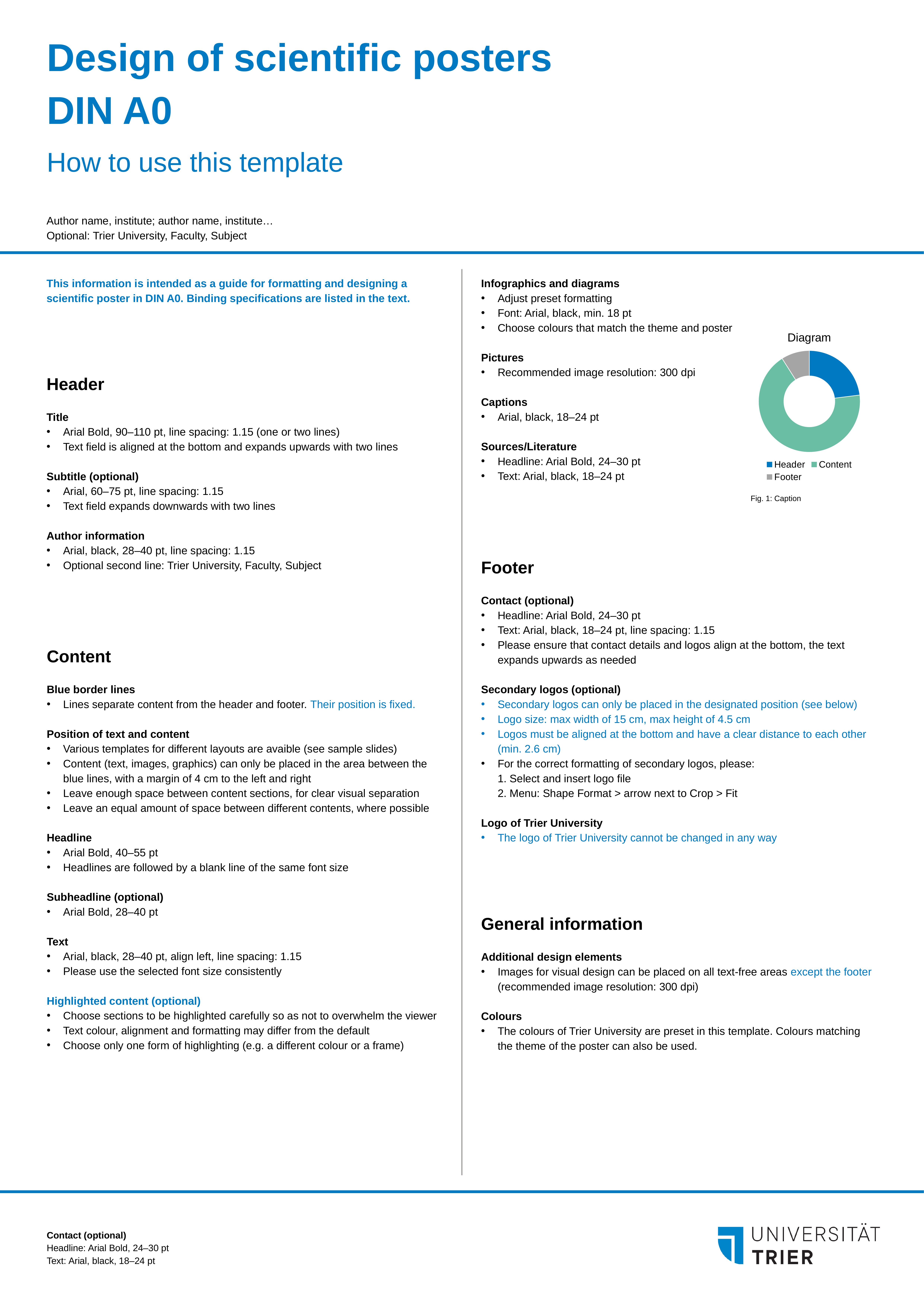
What is the title of the chart? Diagram Which category takes up the largest share of the doughnut chart? Content What entries does the chart legend list? Header, Content, Footer Which is larger in the doughnut chart, Content or Footer? Content Which is larger in the doughnut chart, Header or Footer? Header How many categories does the doughnut chart show? 3 Which is larger in the doughnut chart, Content or Header? Content What kind of chart is shown on the slide? Doughnut chart Which category takes up the smallest share of the doughnut chart? Footer